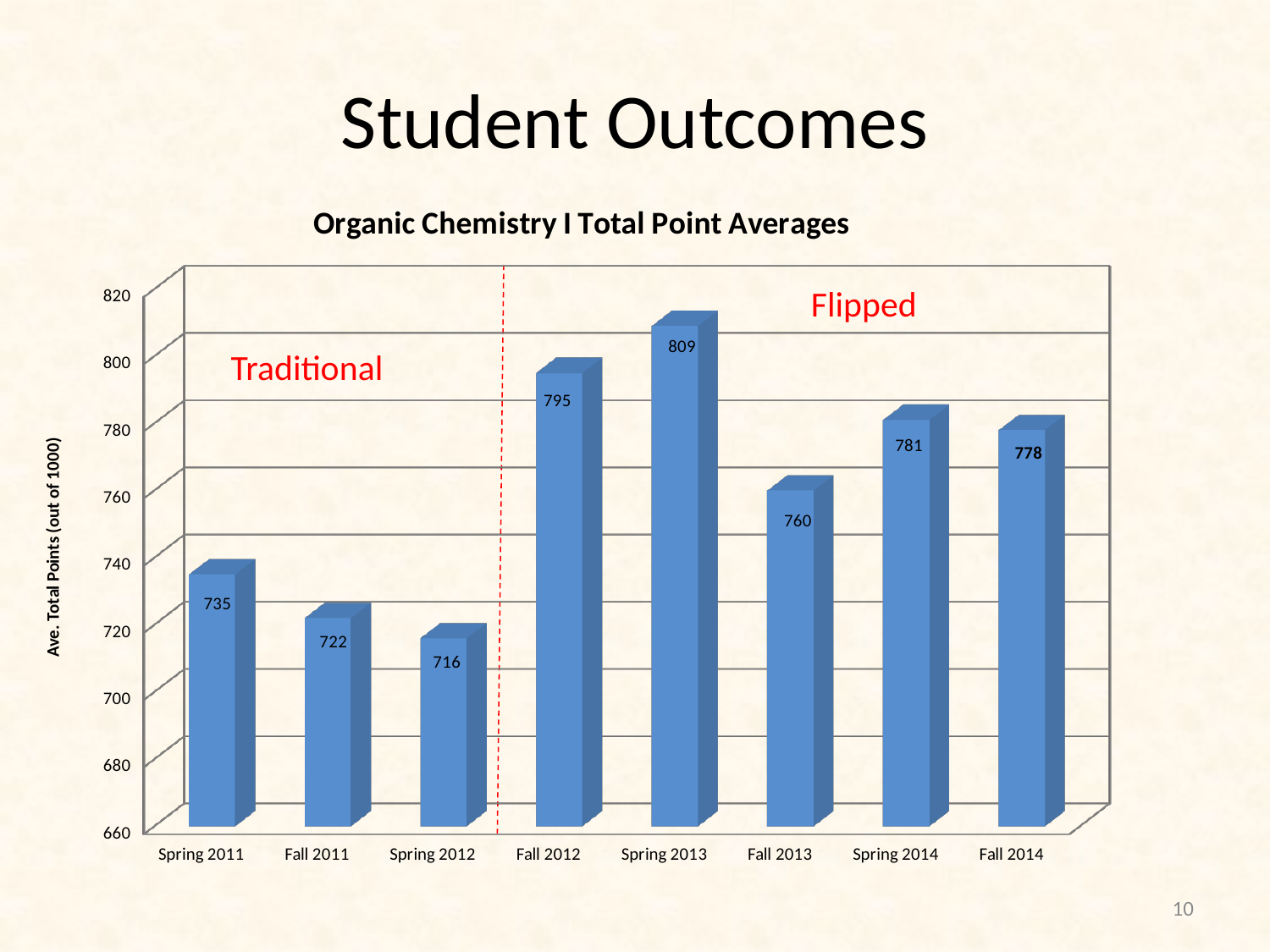
What kind of chart is shown on the slide? bar chart Is the value for Fall 2011 greater or less than 740? less What is the title of the chart? Organic Chemistry I Total Point Averages Which semester has the highest average total points? Spring 2013 Do the values rise or fall from Spring 2011 to Spring 2012? fall What is the difference between the values for Fall 2012 and Spring 2012? 79 What is the value for Spring 2013? 809 How many semesters are shown on the x axis? 8 Which semester has the lowest average total points? Spring 2012 Which is larger, the value for Fall 2013 or the value for Spring 2014? Spring 2014 What is the value for Fall 2014? 778 What is the value for Spring 2011? 735